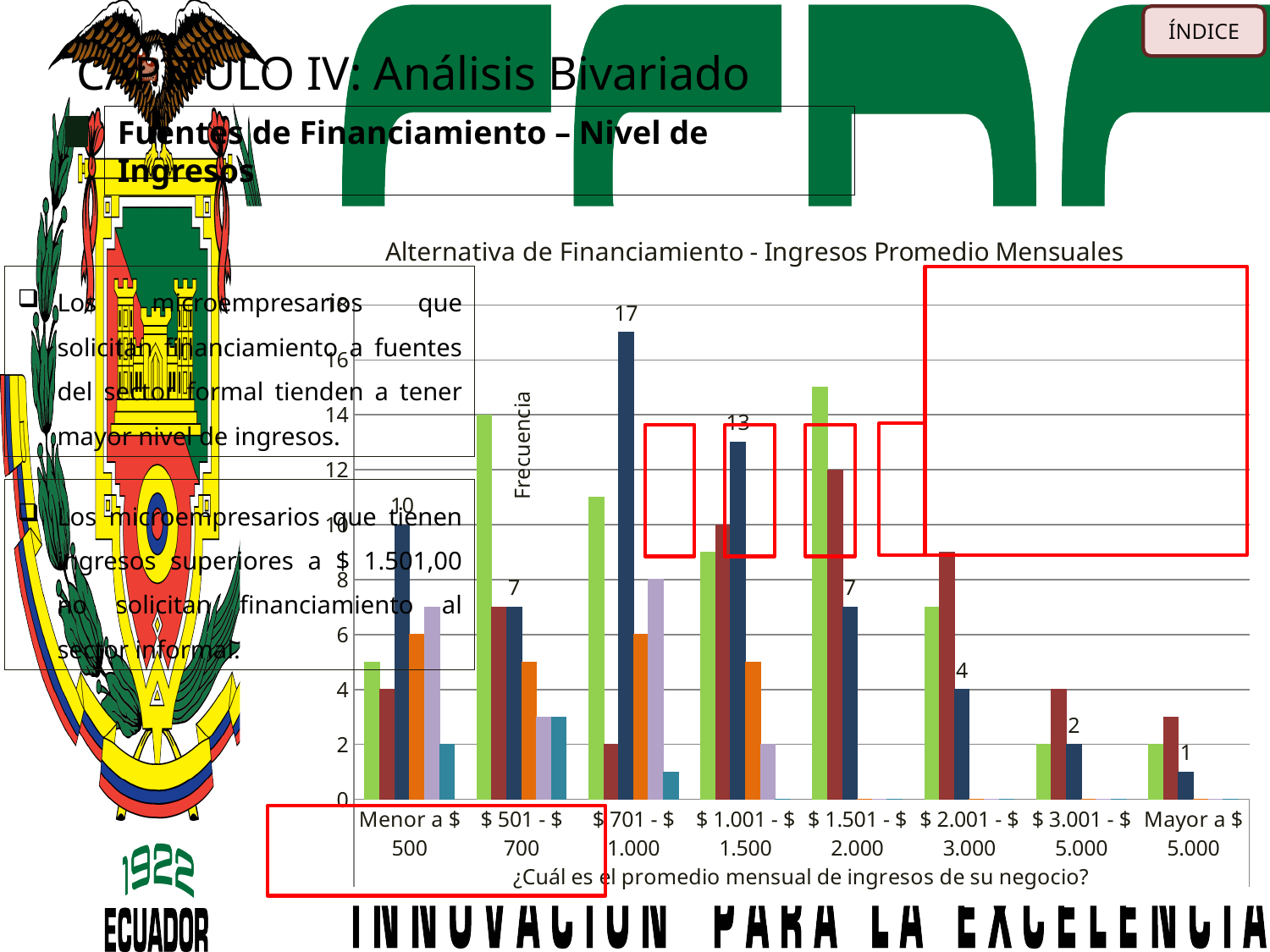
What type of chart is shown on the slide? bar chart What is the title of the chart? Alternativa de Financiamiento - Ingresos Promedio Mensuales What is the highest data label shown on the chart, and for which income category? 17, $ 701 - $ 1.000 What is the value of the dark blue bar for the category '$ 1.001 - $ 1.500'? 13 What is the label of the vertical axis of the chart? Frecuencia What is the value of the dark blue bar for the category 'Menor a $ 500'? 10 Is the value of the green bar for '$ 701 - $ 1.000' greater or less than 10? greater Which is larger: the dark blue bar for '$ 2.001 - $ 3.000' or the dark blue bar for '$ 3.001 - $ 5.000'? $ 2.001 - $ 3.000 How many income categories are shown along the x axis of the chart? 8 What is the difference between the dark blue bar for '$ 701 - $ 1.000' (17) and the dark blue bar for '$ 1.001 - $ 1.500' (13)? 4 Is the value of the green bar for '$ 1.501 - $ 2.000' greater or less than 14? greater What is the value of the dark blue bar for the category 'Mayor a $ 5.000'? 1